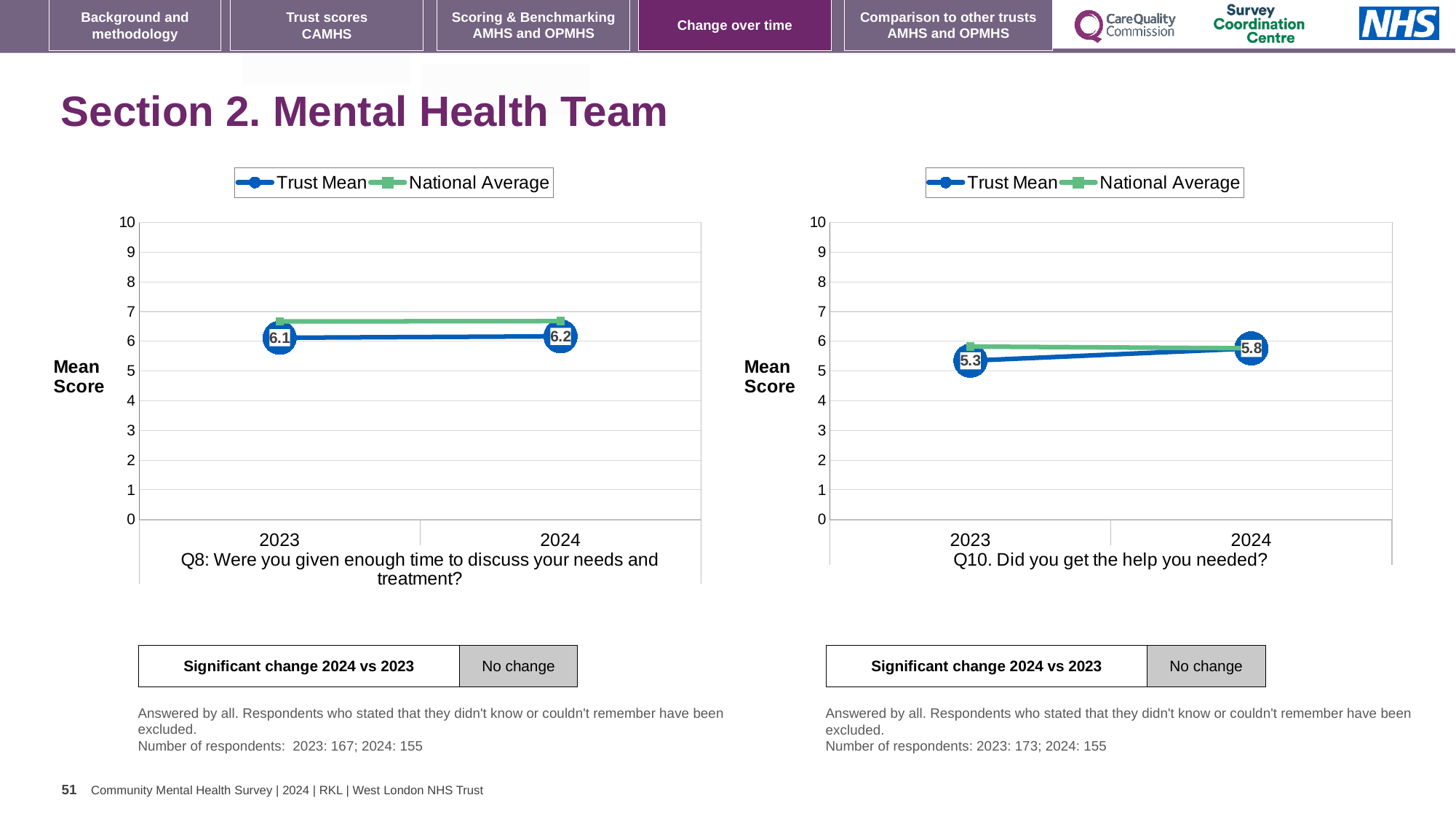
In the Q10 chart on the right, by how much did the Trust Mean change from 2023 to 2024? 0.5 In the Q10 chart on the right, does the Trust Mean rise or fall from 2023 to 2024? rise In the Q8 chart on the left, what is the Trust Mean score for 2024? 6.2 In the Q10 chart on the right, what is the Trust Mean score for 2023? 5.3 What type of chart is used for the Q8 chart on the left? line chart How many series does the legend of the Q10 chart on the right list? 2 How many years are shown on the x axis of the Q8 chart on the left? 2 In the Q8 chart on the left, is the National Average for 2023 greater or less than 6? greater In the Q10 chart on the right, what is the Trust Mean score for 2024? 5.8 In the Q10 chart on the right, which is higher in 2023: the Trust Mean or the National Average? National Average In the Q8 chart on the left, what is the Trust Mean score for 2023? 6.1 In the Q8 chart on the left, what is the difference between the Trust Mean for 2024 and 2023? 0.1